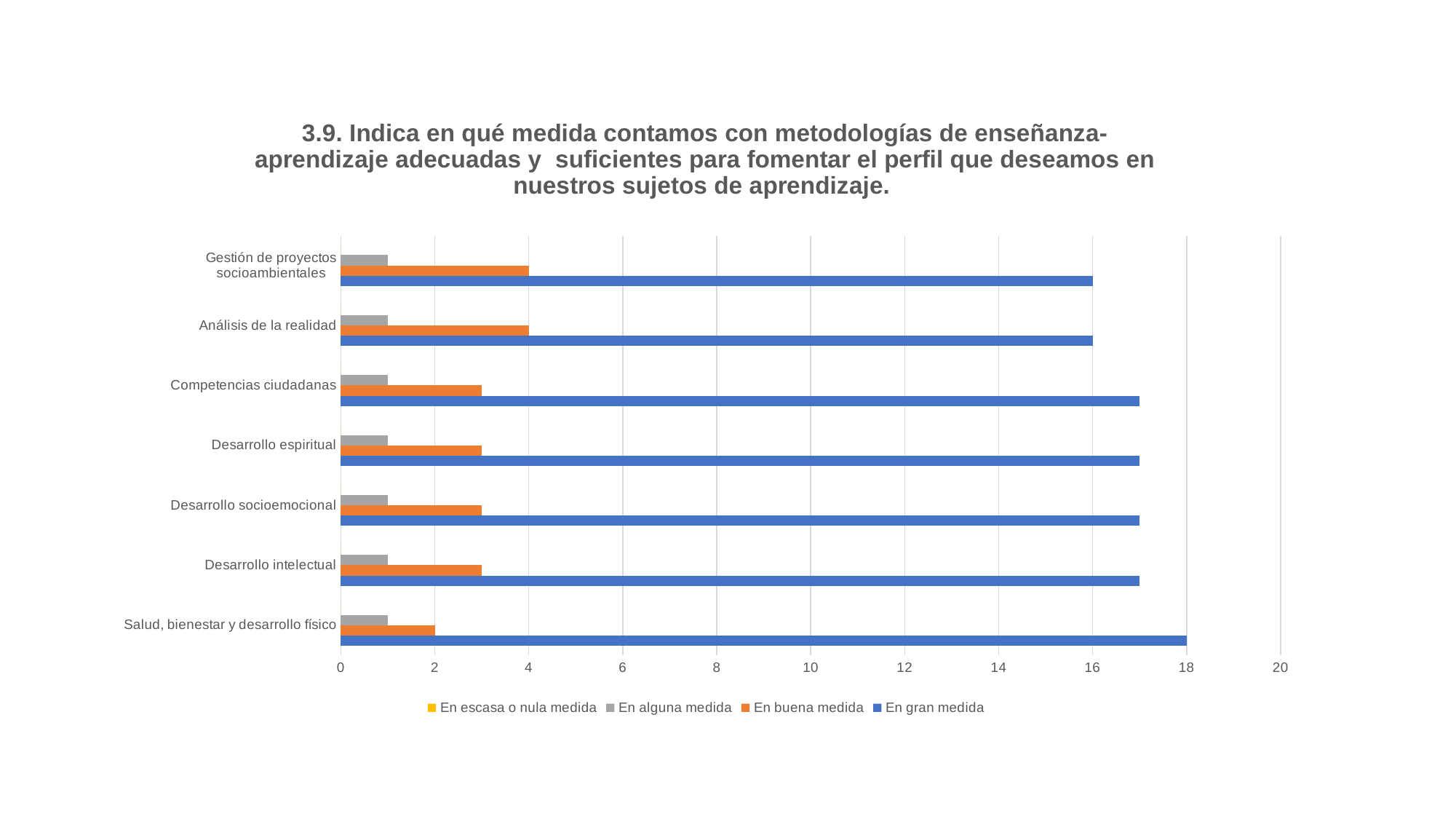
How many series does the legend list? 4 How many categories are plotted on the chart? 7 Which colour represents the "En gran medida" series in the legend? blue Is the "En gran medida" value for "Desarrollo intelectual" greater or less than 16? greater What is the value of "En gran medida" for "Gestión de proyectos socioambientales"? 16 What is the value of "En buena medida" for "Salud, bienestar y desarrollo físico"? 2 What is the value of "En gran medida" for "Salud, bienestar y desarrollo físico"? 18 What is the difference between the "En gran medida" values for "Salud, bienestar y desarrollo físico" and "Análisis de la realidad"? 2 What is the value of "En buena medida" for "Análisis de la realidad"? 4 Which category has the highest value for "En gran medida"? Salud, bienestar y desarrollo físico Is the "En alguna medida" value for "Competencias ciudadanas" greater or less than 2? less What kind of chart is shown on the slide? bar chart